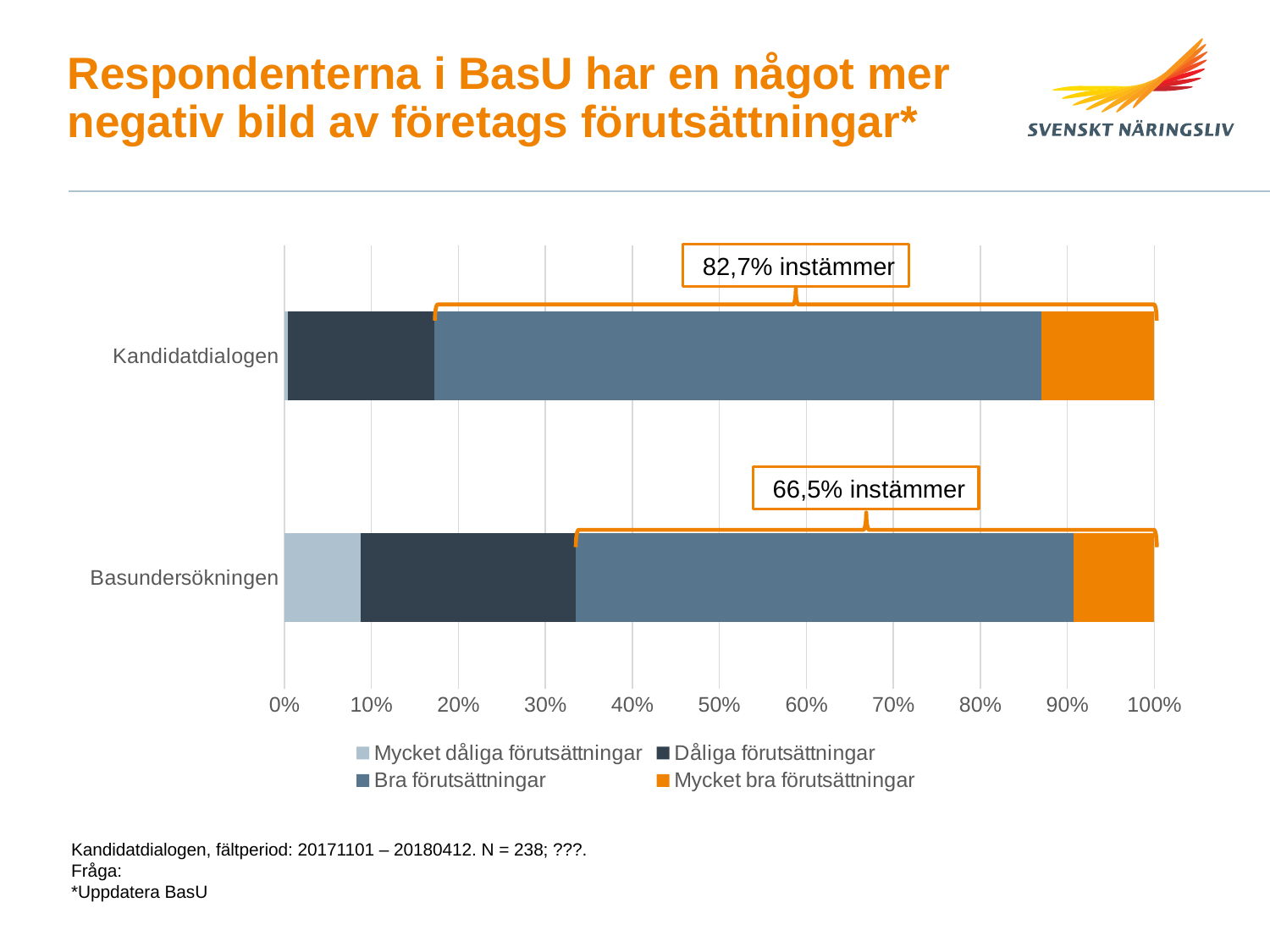
What is the difference in percentage points between the 'instämmer' share for Kandidatdialogen and for Basundersökningen? 16,2 percentage points How many series does the legend list? 4 What share of respondents in Basundersökningen 'instämmer' according to the annotation? 66,5% Which category has the higher 'instämmer' share, Kandidatdialogen or Basundersökningen? Kandidatdialogen Which legend entry is listed first? Mycket dåliga förutsättningar Is the 'Dåliga förutsättningar' segment for Kandidatdialogen greater or less than 20%? less How many categories (bars) does the chart show? 2 Which category has the larger 'Dåliga förutsättningar' segment, Kandidatdialogen or Basundersökningen? Basundersökningen What kind of chart is shown on the slide? Stacked bar chart What share of respondents in Kandidatdialogen 'instämmer' according to the annotation? 82,7% Which colour represents 'Mycket bra förutsättningar' in the legend? Orange Is the 'Bra förutsättningar' segment for Kandidatdialogen greater or less than 60%? greater